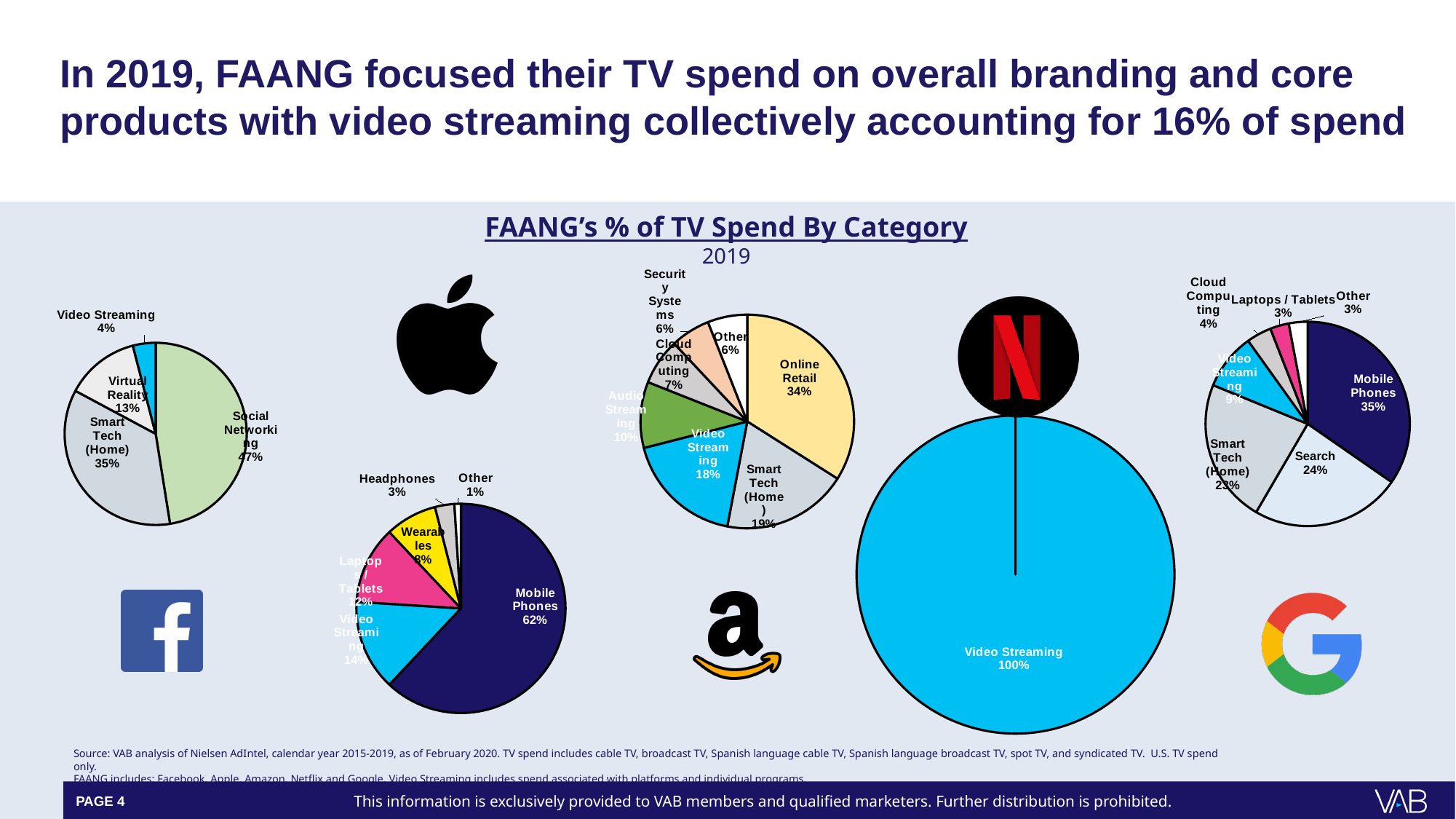
In the Amazon pie chart, what share of TV spend goes to Video Streaming? 18% In the Apple pie chart, what is the difference between the Video Streaming share and the Laptops / Tablets share? 2% In the Google pie chart (rightmost), which category has the largest share? Mobile Phones In the Google pie chart (rightmost), what share of TV spend goes to Search? 24% In the Amazon pie chart, which category has the largest share? Online Retail In the Amazon pie chart, which is larger: Smart Tech (Home) or Audio Streaming? Smart Tech (Home) In the Facebook pie chart (leftmost), which category has the smallest share? Video Streaming In the Apple pie chart, how many categories are shown? 6 In the Apple pie chart, what share of TV spend goes to Mobile Phones? 62% In the Facebook pie chart (leftmost), what share of TV spend goes to Social Networking? 47% What type of charts are used on this slide? Pie charts In the Netflix pie chart, what share of TV spend goes to Video Streaming? 100%